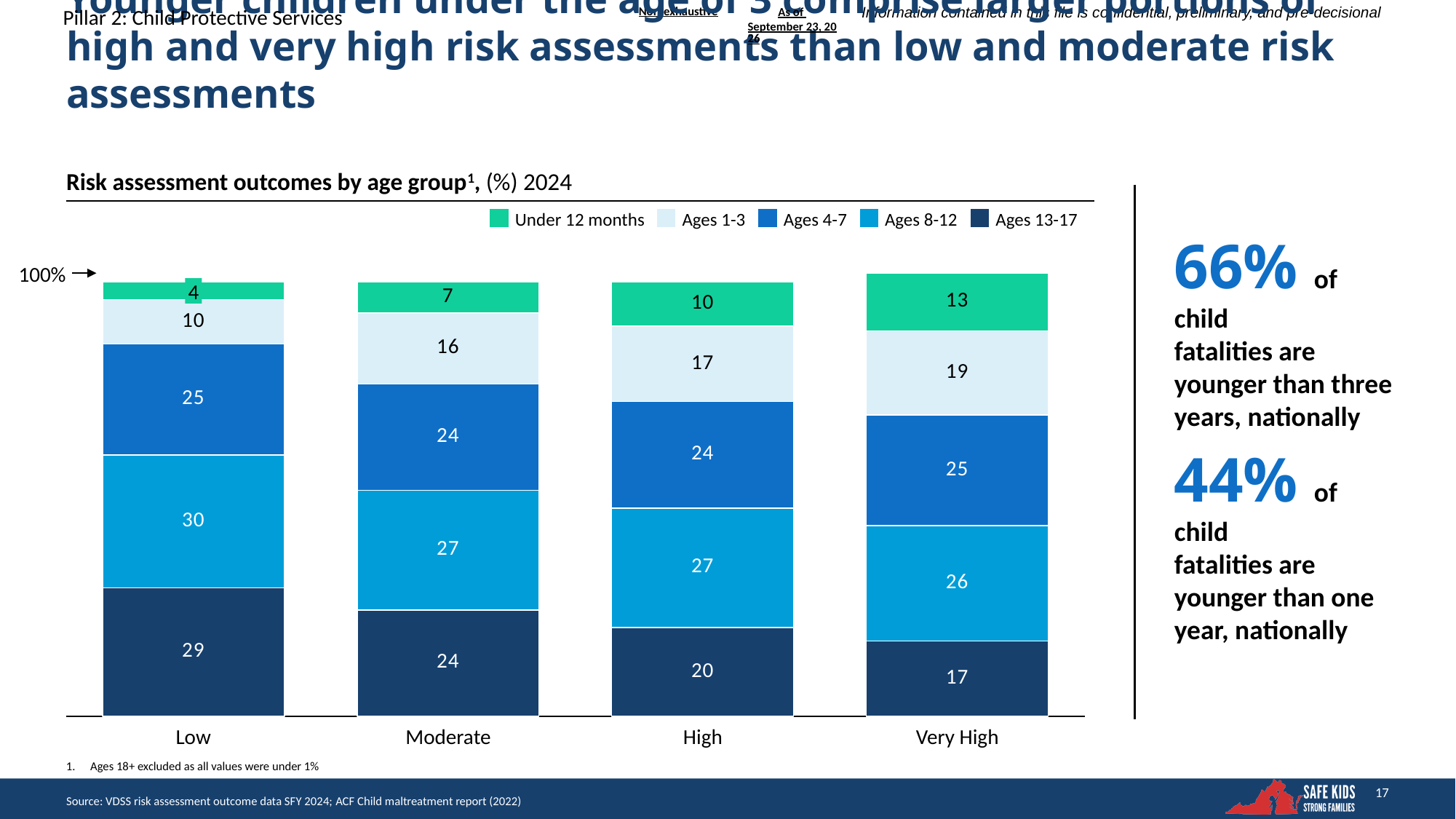
Which risk category has the lowest value for Ages 13-17? Very High What is the difference between the Ages 8-12 values for Low and Very High? 4 What is the value for Under 12 months in the Very High category? 13 Which risk category has the highest value for Under 12 months? Very High What is the value for Ages 1-3 in the Moderate category? 16 Which is larger: the Ages 1-3 value for High or for Low? High What is the value for Ages 13-17 in the Low category? 29 What is the title of the chart? Risk assessment outcomes by age group, (%) 2024 What type of chart is shown on the slide? Stacked bar chart How many risk categories are shown on the x axis? 4 How many series does the legend list? 5 Does the value for Under 12 months rise or fall from Low to Very High? Rise